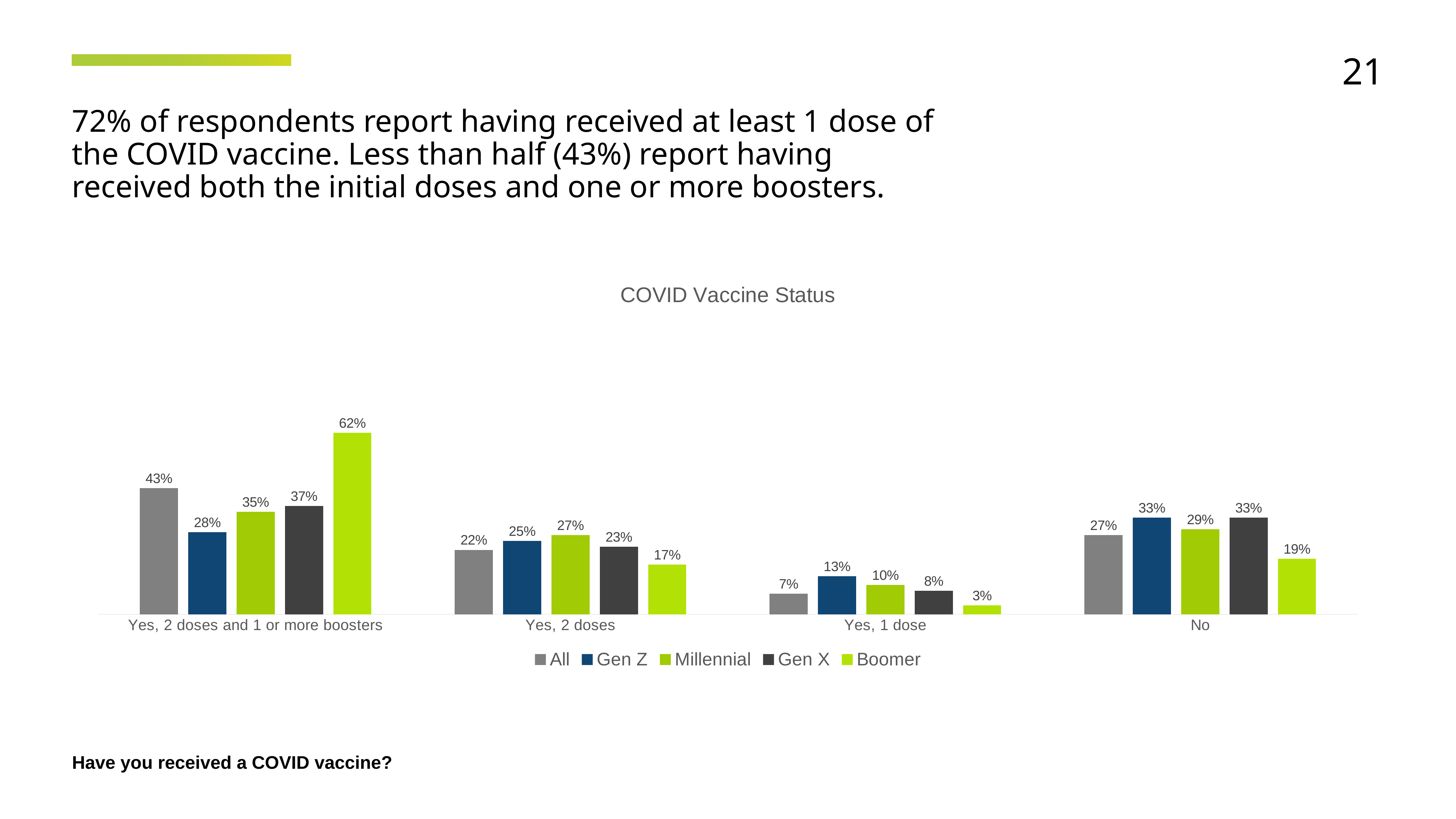
What is the value for Gen Z in the 'Yes, 1 dose' category? 13% What is the difference between the Boomer and All values in the 'Yes, 2 doses and 1 or more boosters' category? 19% How many series does the legend list? 5 What is the value for All in the 'No' category? 27% What is the difference between the Gen Z and Boomer values in the 'No' category? 14% Which series has the highest value in the 'Yes, 2 doses and 1 or more boosters' category? Boomer What is the value for Boomer in the 'Yes, 2 doses and 1 or more boosters' category? 62% Which series has the lowest value in the 'Yes, 1 dose' category? Boomer Which is larger in the 'Yes, 2 doses' category: Millennial or Gen X? Millennial How many categories are shown on the x axis? 4 What is the title of the chart? COVID Vaccine Status What kind of chart is shown on the slide? Bar chart